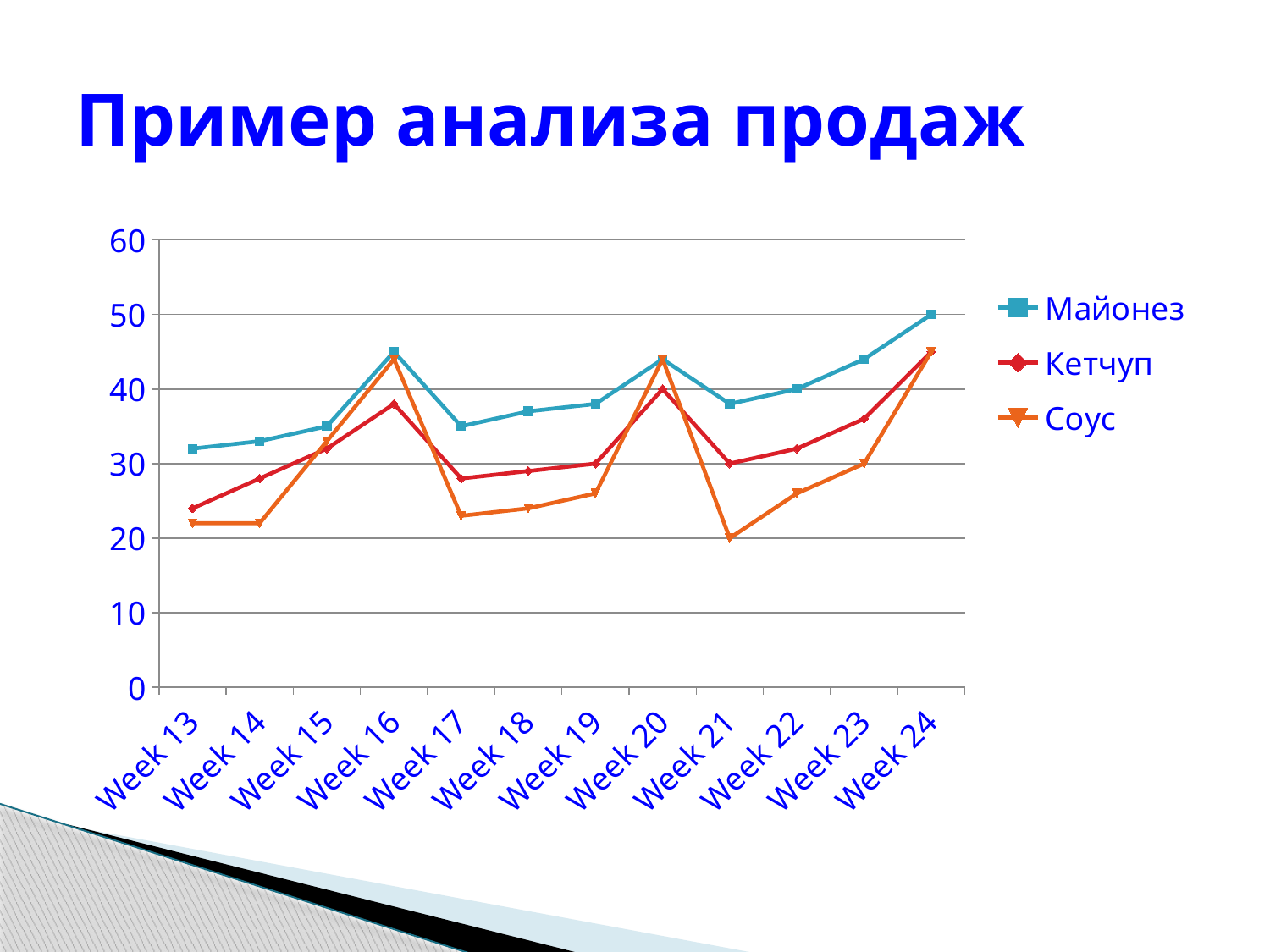
Which series is lowest at Week 21? Соус How many series does the legend list? 3 What kind of chart is shown on the slide? line chart Which series is drawn with triangle markers in the legend? Соус Which is larger at Week 15: the value for Майонез or the value for Соус? Майонез Which series is highest at Week 24? Майонез What is the title of the slide above the chart? Пример анализа продаж Does the Майонез line rise or fall from Week 21 to Week 24? rise Is the value for Майонез at Week 13 greater or less than 40? less Is the value for Кетчуп at Week 17 greater or less than 30? less Is the value for Соус at Week 16 greater or less than 40? greater How many weeks are plotted along the x axis? 12